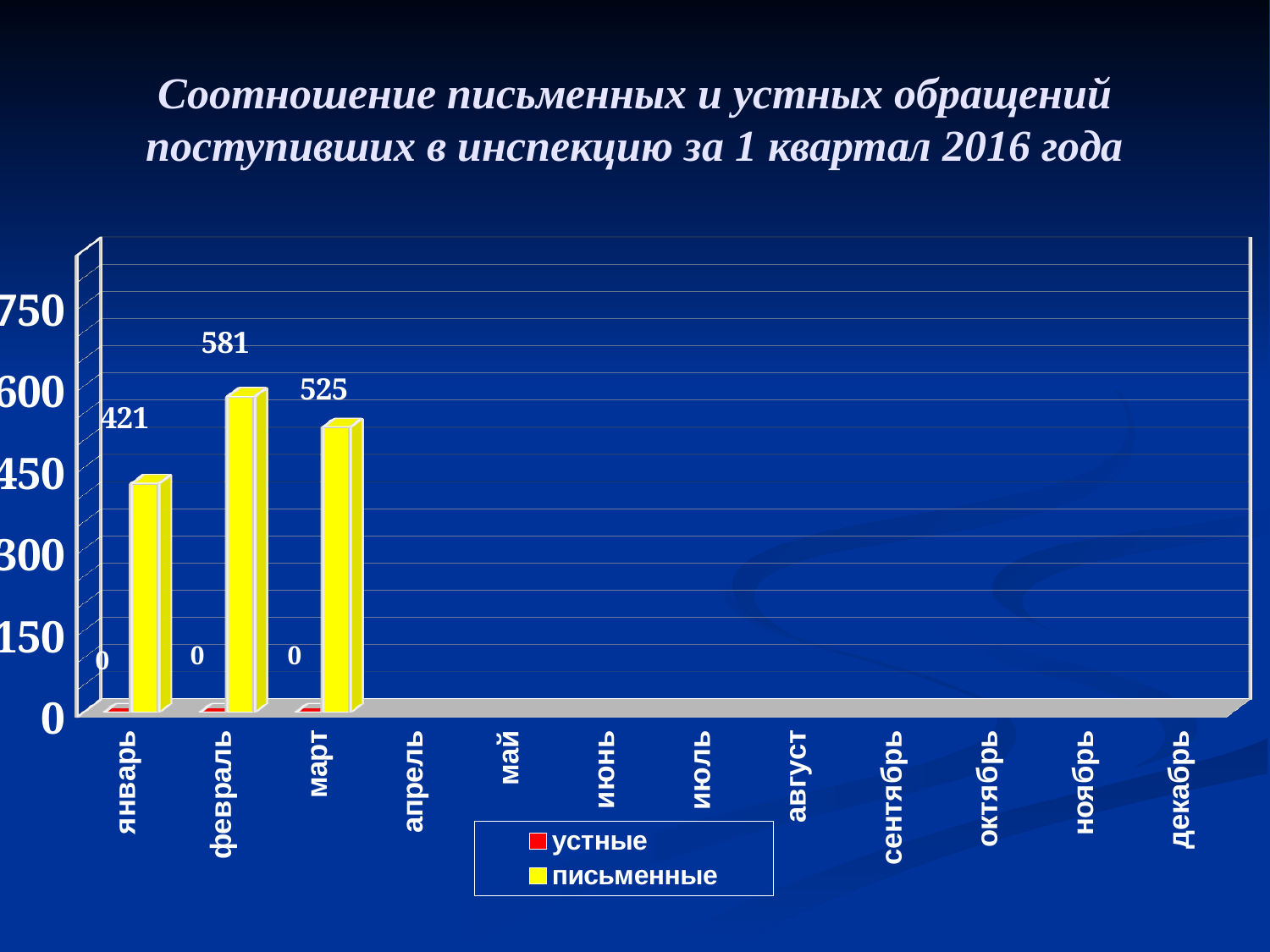
How many series does the legend list? 2 What is the value for письменные in январь? 421 What is the difference between the письменные values for февраль and январь? 160 What is the value for письменные in февраль? 581 Which month has the highest value for письменные? февраль What kind of chart is shown on the slide? bar chart How many months are shown on the x axis? 12 Which is larger, the письменные value for март or for январь? март What is the value for устные in январь? 0 Is the value for письменные in февраль greater or less than 450? greater Among the months with data labels, which month has the lowest value for письменные? январь What is the value for письменные in март? 525